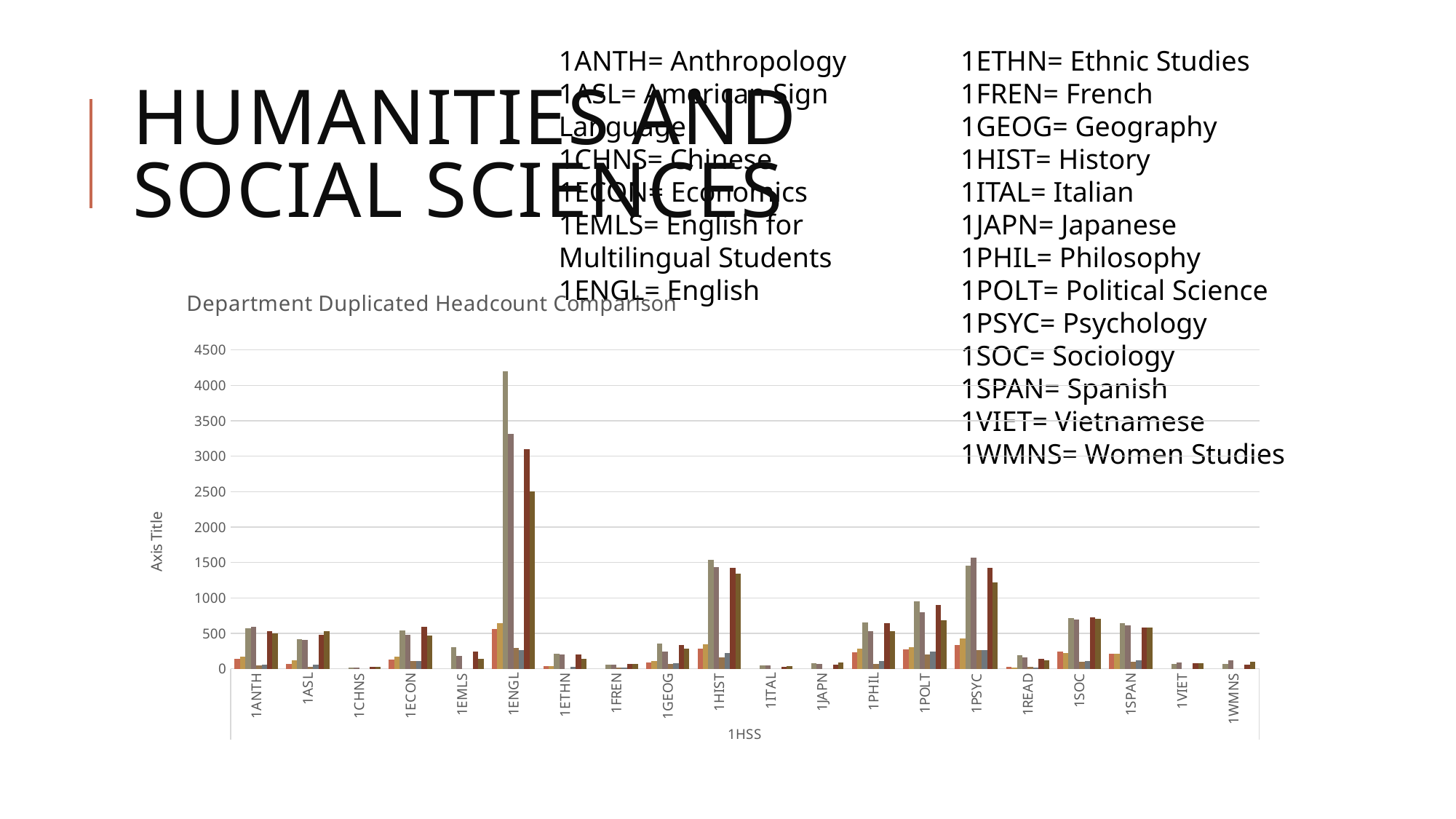
How many department categories are shown along the x axis of the chart? 20 Which has a taller tallest bar, 1PHIL or 1FREN? 1PHIL What kind of chart is shown on the slide? bar chart Is the tallest bar for 1HIST greater or less than 1000? greater Is the tallest bar for 1PSYC greater or less than 1000? greater Is the tallest bar for 1CHNS greater or less than 500? less What is the label shown on the x axis of the chart? 1HSS What is the title of the chart? Department Duplicated Headcount Comparison Which has a taller tallest bar, 1ENGL or 1HIST? 1ENGL Which department category has the tallest bar in the chart? 1ENGL